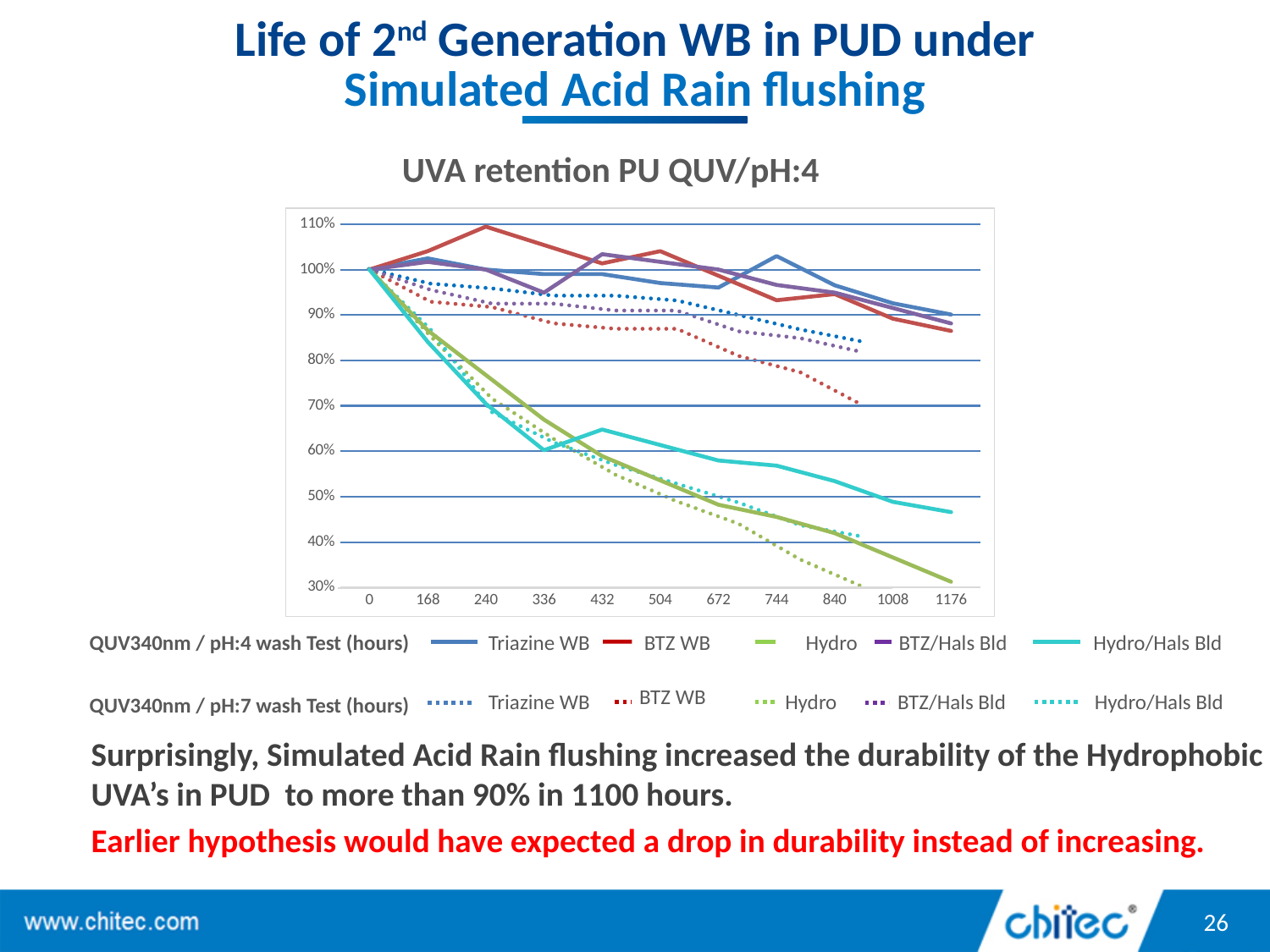
What is the title of the chart? UVA retention PU QUV/pH:4 How many series does the legend list in total? 10 What kind of chart is shown on the slide? line chart Is the value of the solid Hydro (pH:4) line at 1176 hours greater or less than 40%? less How many points are labelled on the x axis of the chart? 11 Is the value of the solid BTZ WB (pH:4) line at 240 hours greater or less than 100%? greater Among the solid pH:4 lines, which series has the lowest value at 1176 hours? Hydro How many series are listed under the QUV340nm / pH:4 wash Test legend? 5 Is the final value of the dotted BTZ WB (pH:7) line greater or less than 80%? less Does the solid Hydro (pH:4) line rise or fall along the x axis? fall At 1176 hours, which is higher: the solid Triazine WB (pH:4) line or the solid Hydro (pH:4) line? Triazine WB